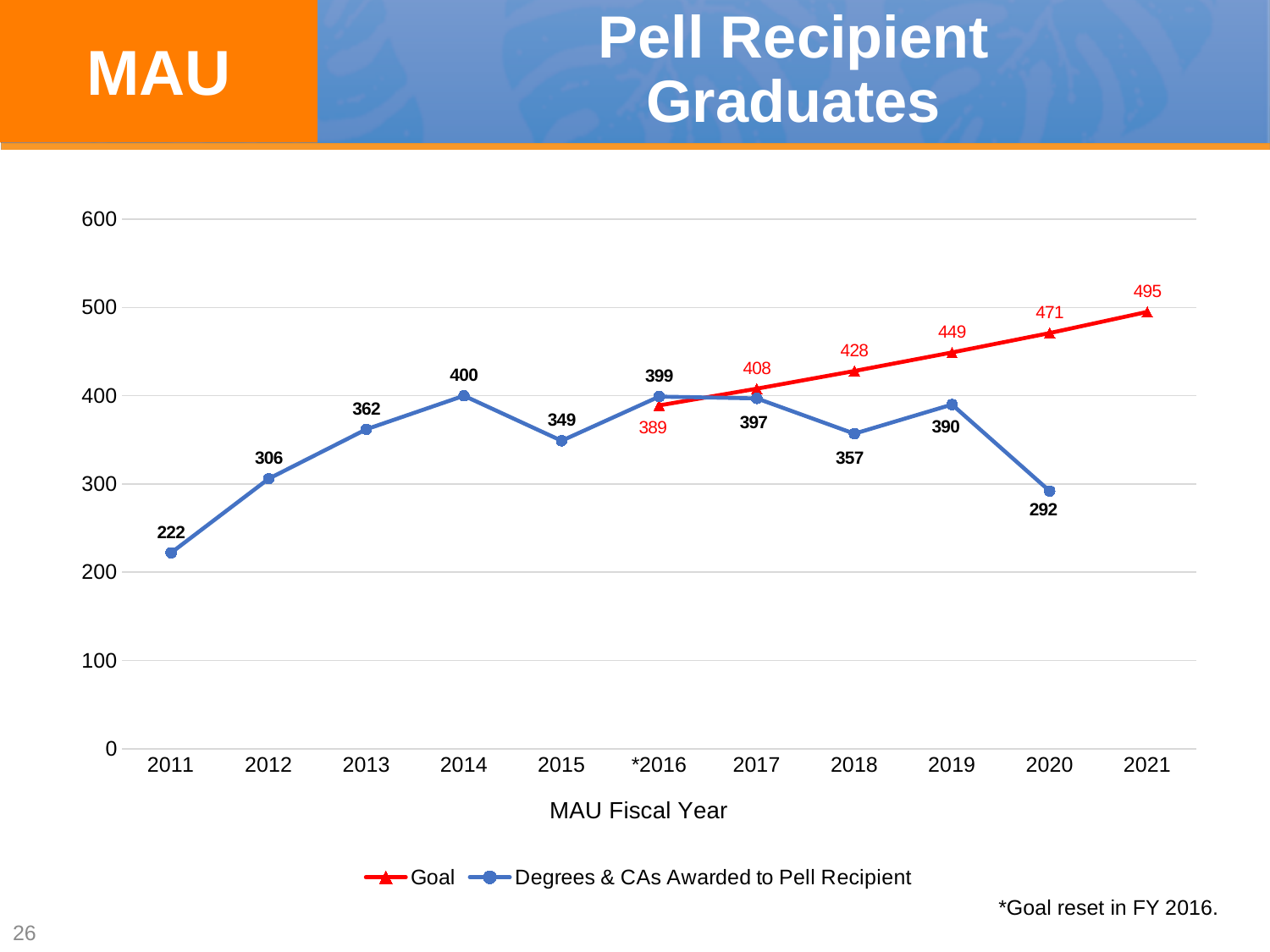
What is the difference between the Goal and the Degrees & CAs Awarded to Pell Recipient in 2019? 59 How many series does the legend list? 2 What was the number of Degrees & CAs Awarded to Pell Recipient in 2014? 400 What kind of chart is shown on the slide? Line chart In which year was the number of Degrees & CAs Awarded to Pell Recipient the lowest? 2011 In which year was the number of Degrees & CAs Awarded to Pell Recipient the highest? 2014 What was the number of Degrees & CAs Awarded to Pell Recipient in 2020? 292 How many fiscal years are shown on the x axis? 11 What is the label of the x axis? MAU Fiscal Year What is the Goal value for 2021? 495 Which is larger in 2017: the Goal or the Degrees & CAs Awarded to Pell Recipient? Goal Does the Goal series rise or fall from 2016 to 2021? Rise